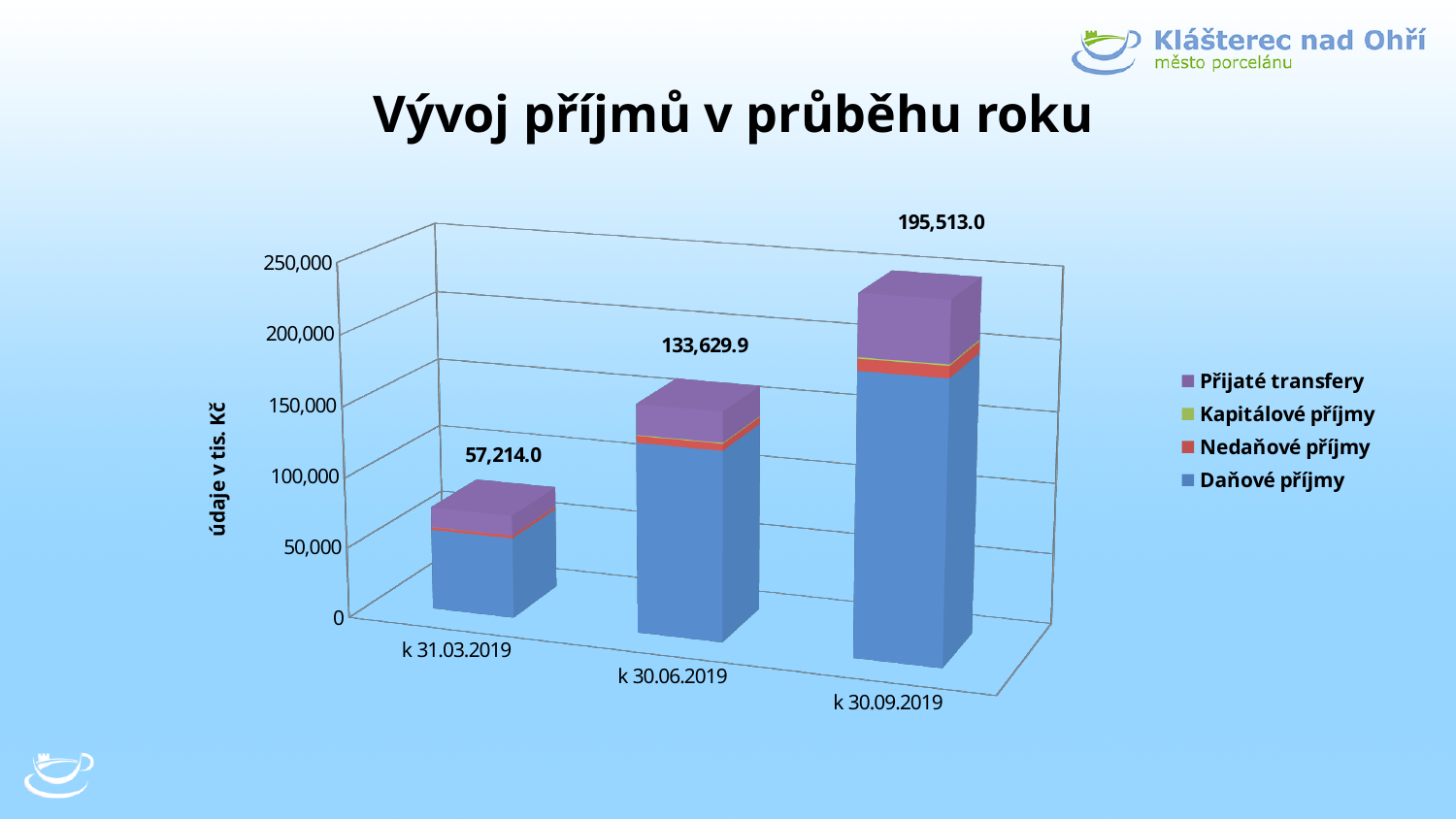
What is the total labelled on the bar for k 30.09.2019? 195,513.0 Which is larger, the total for k 30.06.2019 or the total for k 31.03.2019? k 30.06.2019 How many series does the legend list? 4 What kind of chart is shown on the slide? Stacked bar chart What is the total labelled on the bar for k 31.03.2019? 57,214.0 How many dates (bars) are shown on the chart? 3 Which date has the highest total income? k 30.09.2019 What is the total labelled on the bar for k 30.06.2019? 133,629.9 Which date has the lowest total income? k 31.03.2019 Do the total values rise or fall from k 31.03.2019 to k 30.09.2019? Rise